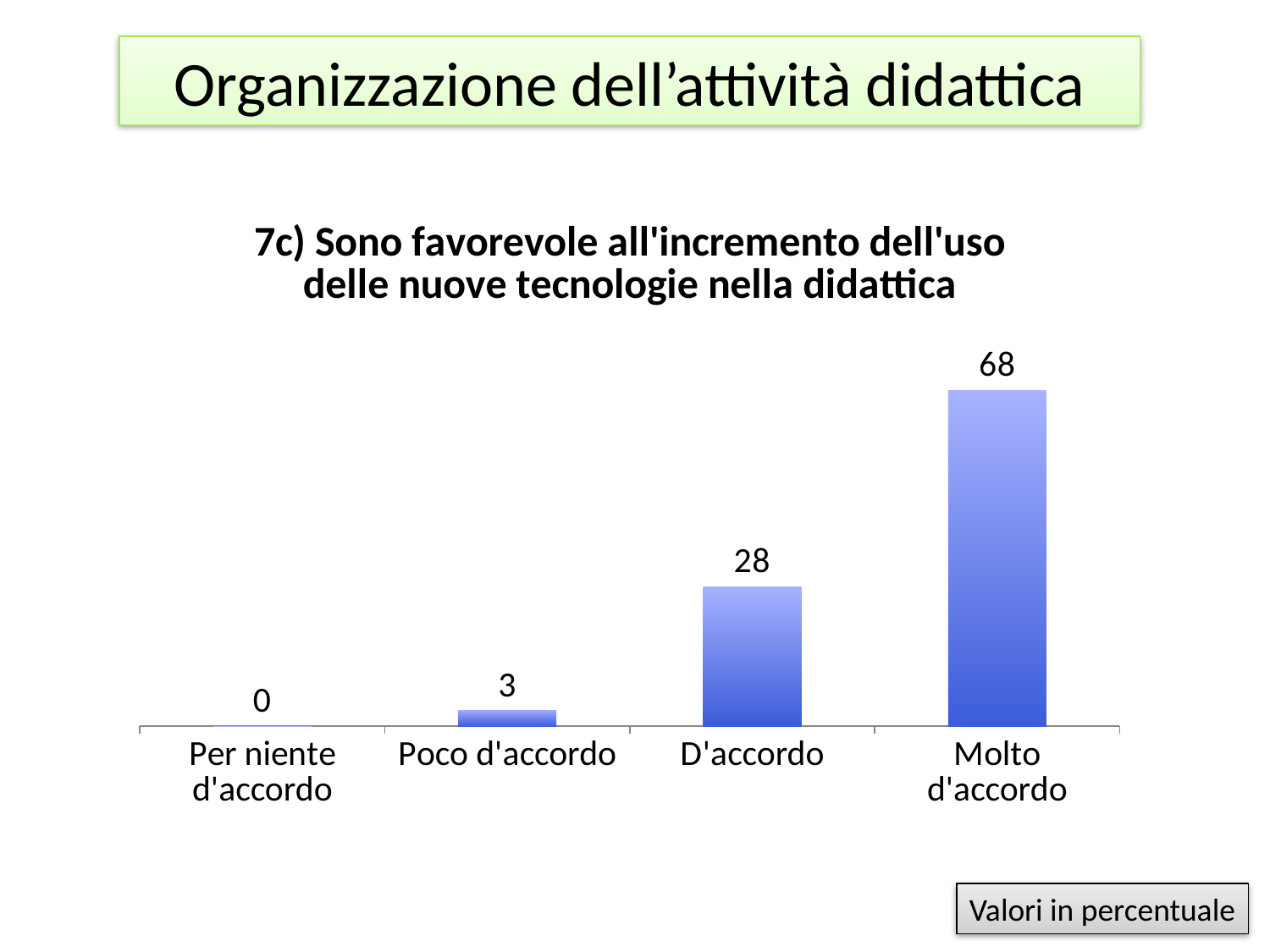
What is the title of the chart? 7c) Sono favorevole all'incremento dell'uso delle nuove tecnologie nella didattica Which category has the highest value? Molto d'accordo Which category has the lowest value? Per niente d'accordo What is the value for "D'accordo"? 28 What is the difference between the values for "Molto d'accordo" and "D'accordo"? 40 Which is larger, the value for "D'accordo" or the value for "Poco d'accordo"? D'accordo How many categories are shown on the x axis? 4 What is the value for "Per niente d'accordo"? 0 What is the value for "Molto d'accordo"? 68 Do the values rise or fall from left to right along the x axis? Rise What kind of chart is shown on the slide? Bar chart What is the value for "Poco d'accordo"? 3